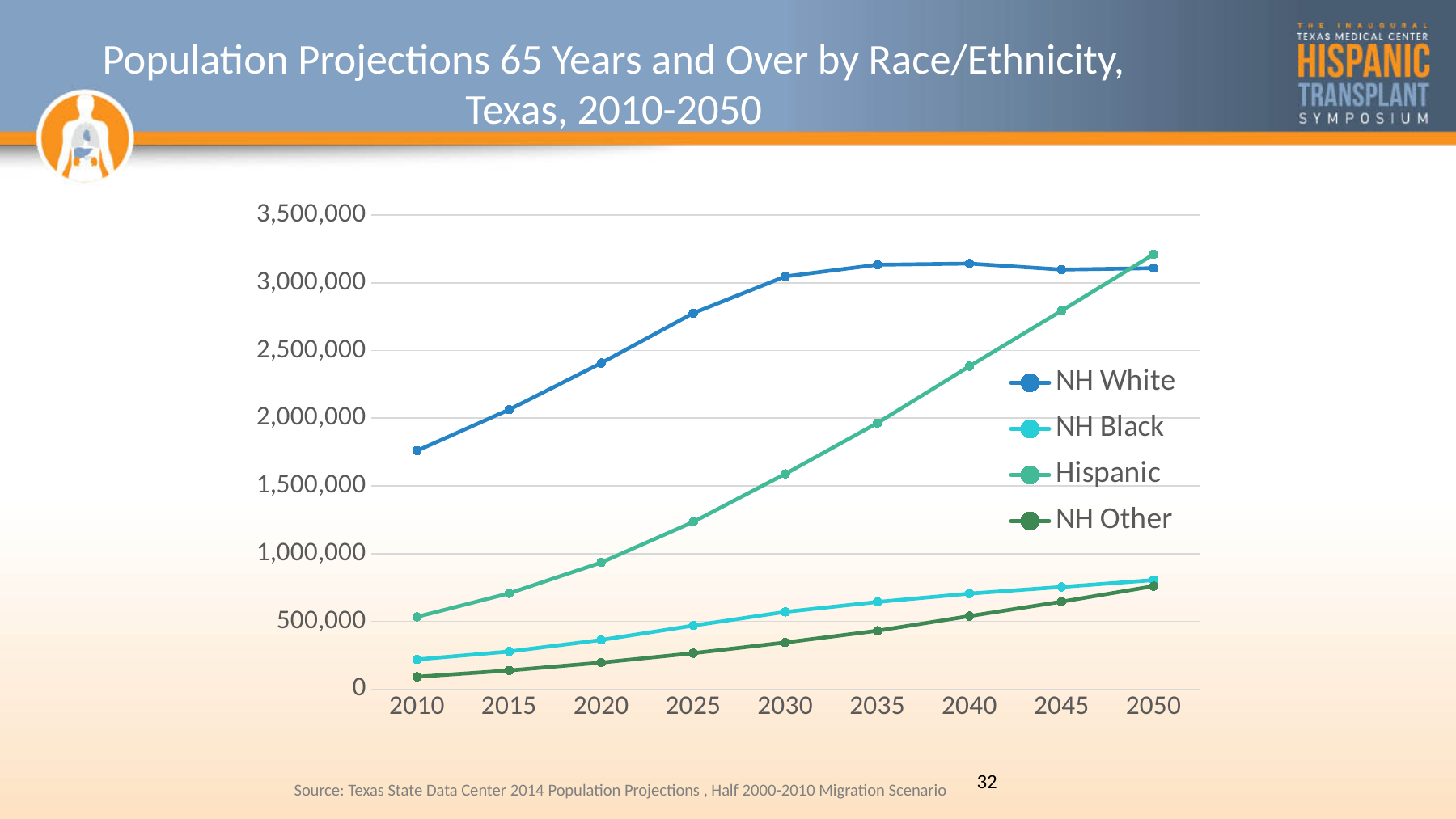
How many series does the legend list? 4 What is the title of the chart on the slide? Population Projections 65 Years and Over by Race/Ethnicity, Texas, 2010-2050 Which series has the highest value in 2010? NH White Is the value for Hispanic in 2040 greater or less than 2,000,000? greater In 2030, which is larger, NH Black or NH Other? NH Black Do the values for Hispanic rise or fall from 2010 to 2050? rise How many years are plotted along the x axis? 9 Which series has the lowest value in 2010? NH Other Which series has the highest value in 2050? Hispanic What kind of chart is shown on the slide? line chart Is the value for NH Black in 2050 greater or less than 1,000,000? less Is the value for NH White in 2025 greater or less than 2,500,000? greater